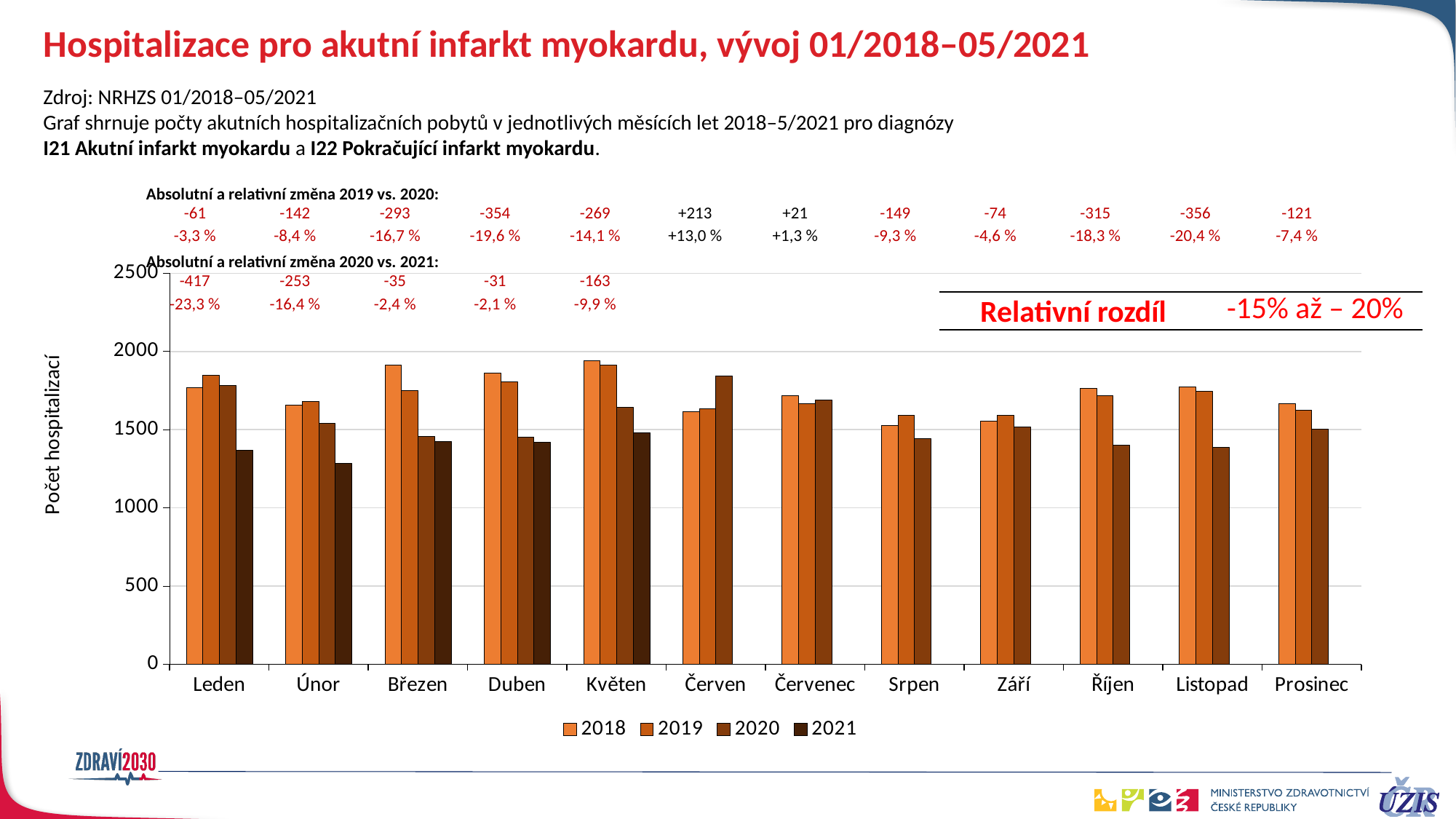
What is the relative change 2019 vs. 2020 printed for Listopad? -20,4 % Is the value for 2021 in Leden greater or less than 1500? less What is the label of the y axis? Počet hospitalizací How many series does the legend list? 4 In Červen, which is larger: the 2018 bar or the 2020 bar? 2020 How many months are shown on the x axis? 12 Is the value for 2018 in Květen greater or less than 1500? greater Which month has the lowest 2021 bar? Únor What kind of chart is shown on the slide? bar chart What is the absolute change 2019 vs. 2020 printed for Duben? -354 Is the value for 2021 in Únor greater or less than 1500? less What is the relative change 2020 vs. 2021 printed for Leden? -23,3 %